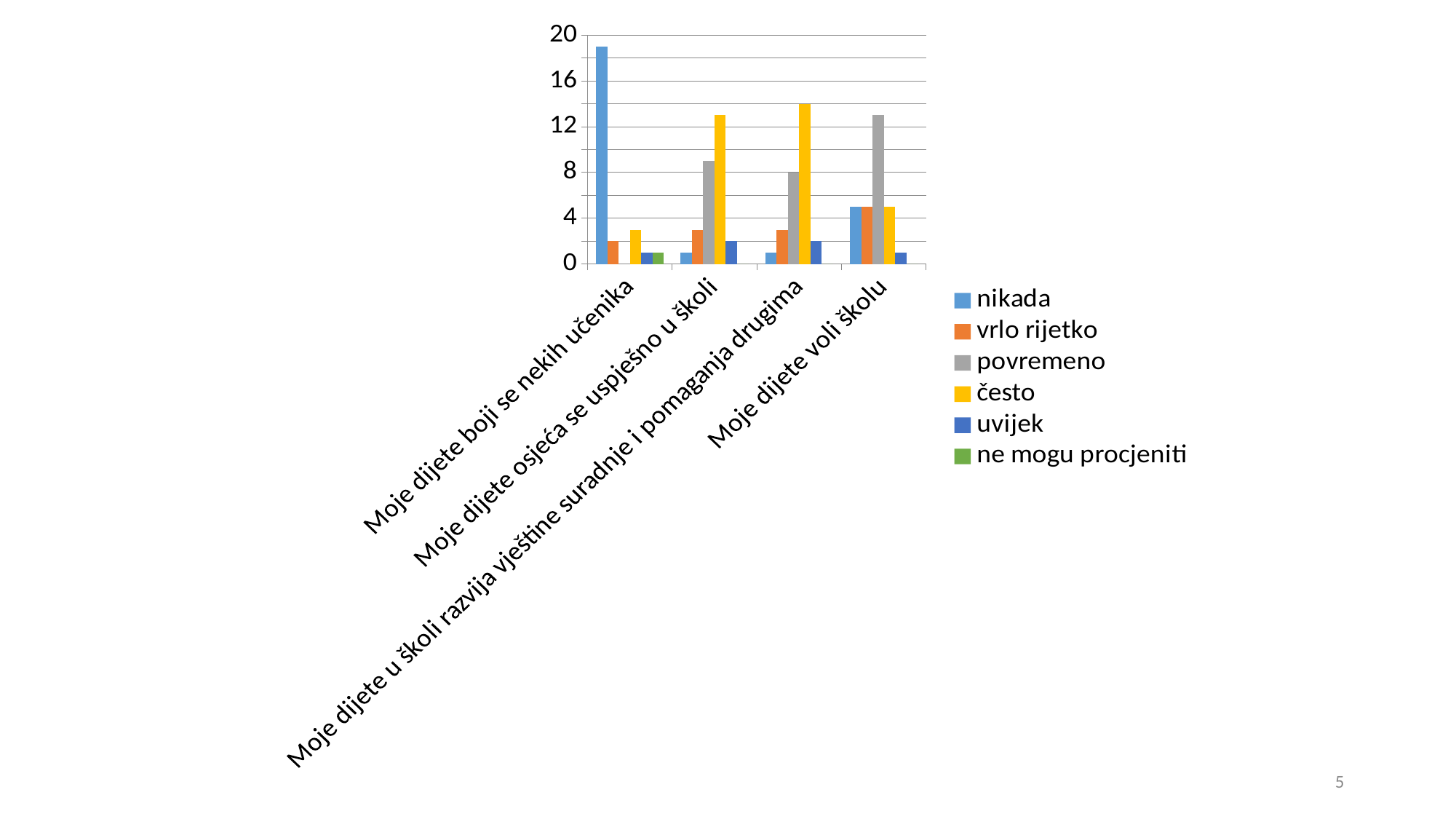
Is the value of "povremeno" for "Moje dijete voli školu" greater or less than 12? greater For "Moje dijete osjeća se uspješno u školi", which is larger: "često" or "povremeno"? često How many categories are shown along the x axis? 4 How many series does the legend list? 6 Which series has the highest value for "Moje dijete voli školu"? povremeno Is the value of "povremeno" for "Moje dijete osjeća se uspješno u školi" greater or less than 12? less Is the value of "nikada" for "Moje dijete boji se nekih učenika" greater or less than 16? greater What kind of chart is shown on the slide? bar chart Which series has the highest value for "Moje dijete u školi razvija vještine suradnje i pomaganja drugima"? često Which series has the highest value for "Moje dijete boji se nekih učenika"? nikada What colour represents the "često" series in the legend? yellow